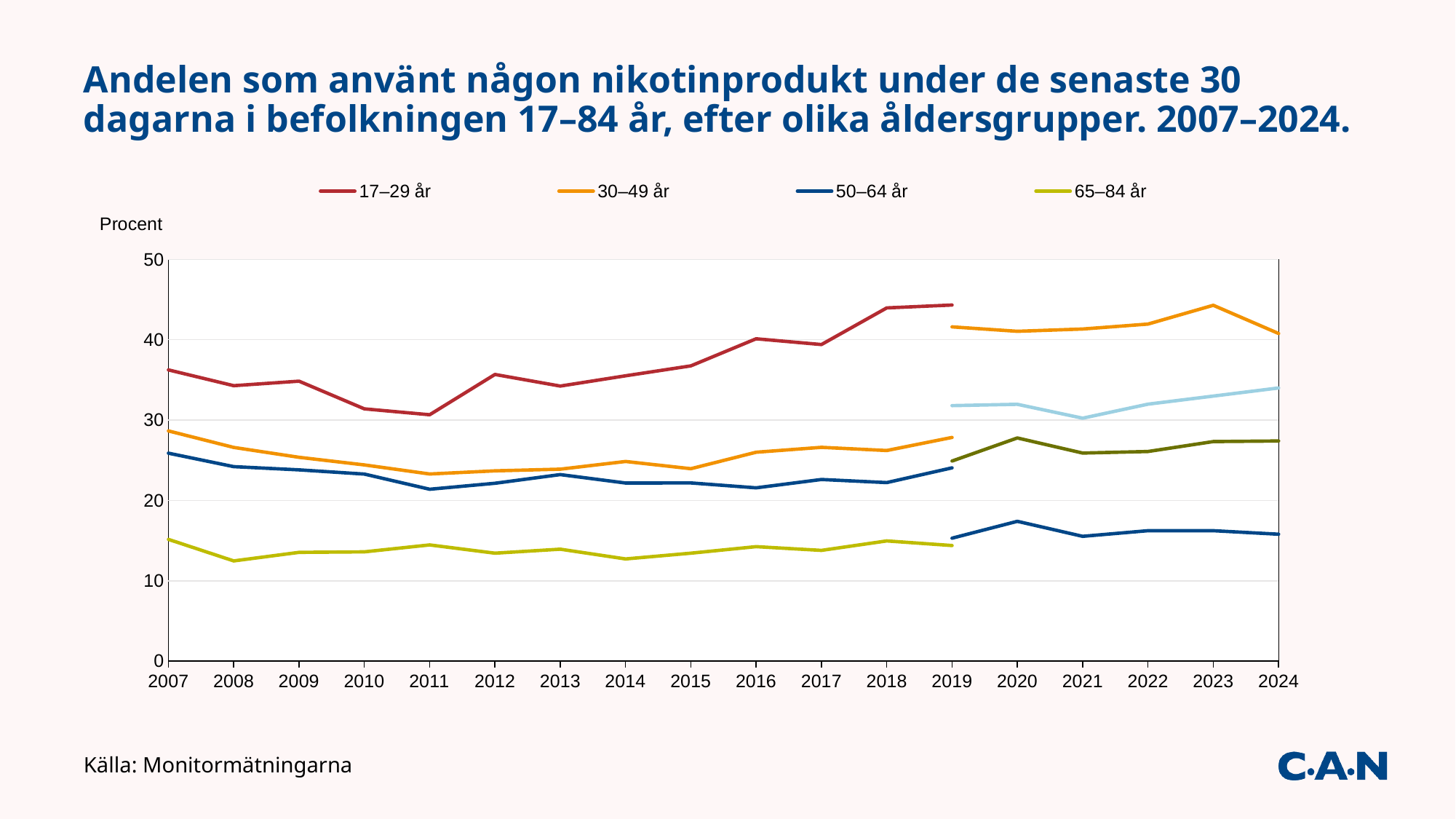
Is the value for 65–84 år in 2008 greater or less than 20? less Which age group has the highest value in 2007? 17–29 år Is the value for 17–29 år in 2018 greater or less than 40? greater How many years are shown along the x axis? 18 What kind of chart is shown on the slide? line chart Does the value for 17–29 år rise or fall from 2013 to 2018? rise Which age group has the lowest value in 2007? 65–84 år Is the value for 30–49 år in 2011 greater or less than 30? less In 2007, which is larger: the value for 30–49 år or the value for 50–64 år? 30–49 år How many series does the legend list? 4 What is the label on the y axis? Procent